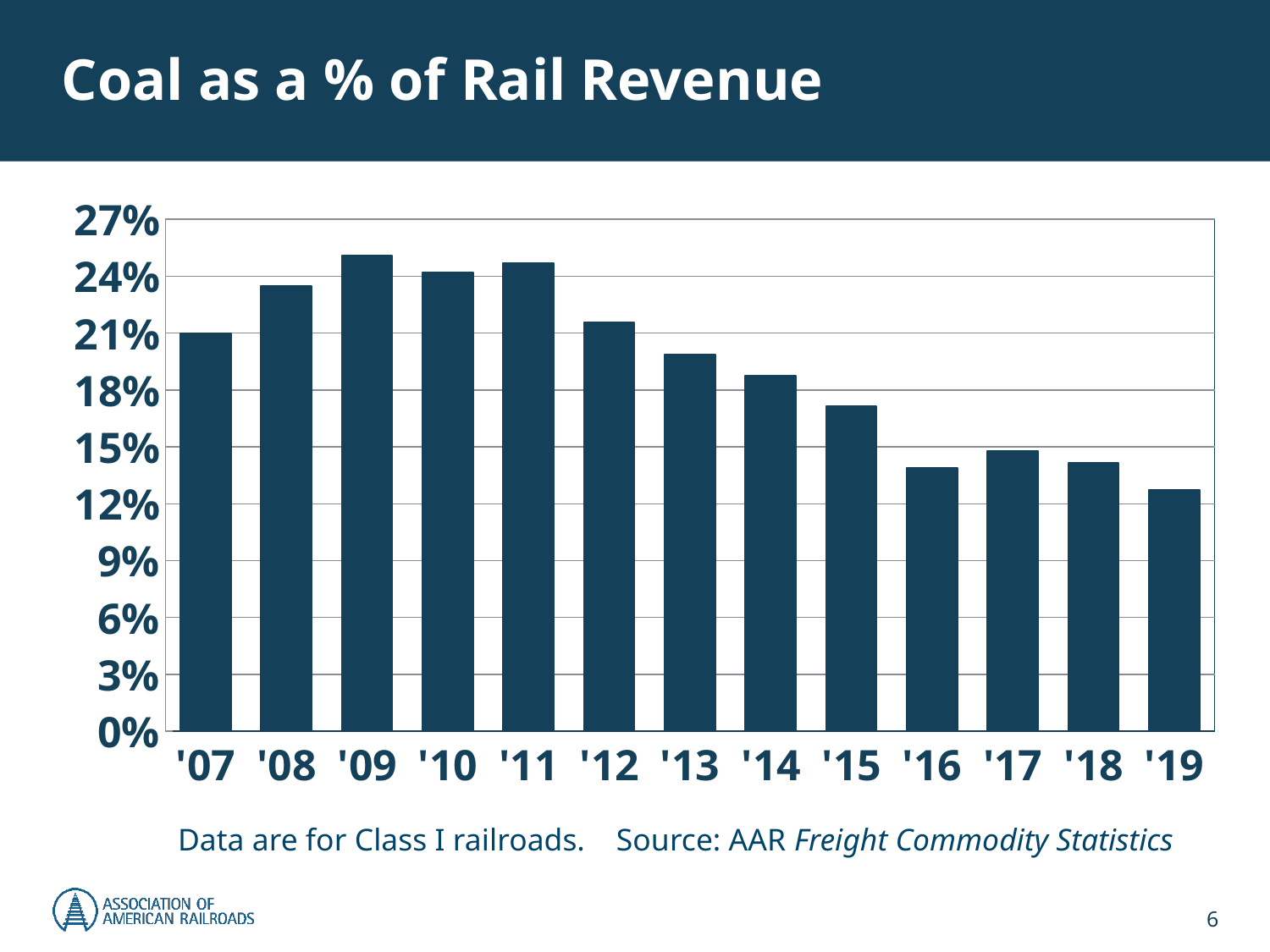
Is the value for '19 greater or less than 15%? less Which year has the lowest coal share of rail revenue? '19 How many years are shown on the x axis of the chart? 13 Is the value for '16 greater or less than 15%? less Which is larger, the value for '16 or the value for '17? '17 Do the values rise or fall from '11 to '19? fall Is the value for '13 greater or less than 18%? greater What is the title of the chart? Coal as a % of Rail Revenue What kind of chart is shown on the slide? bar chart